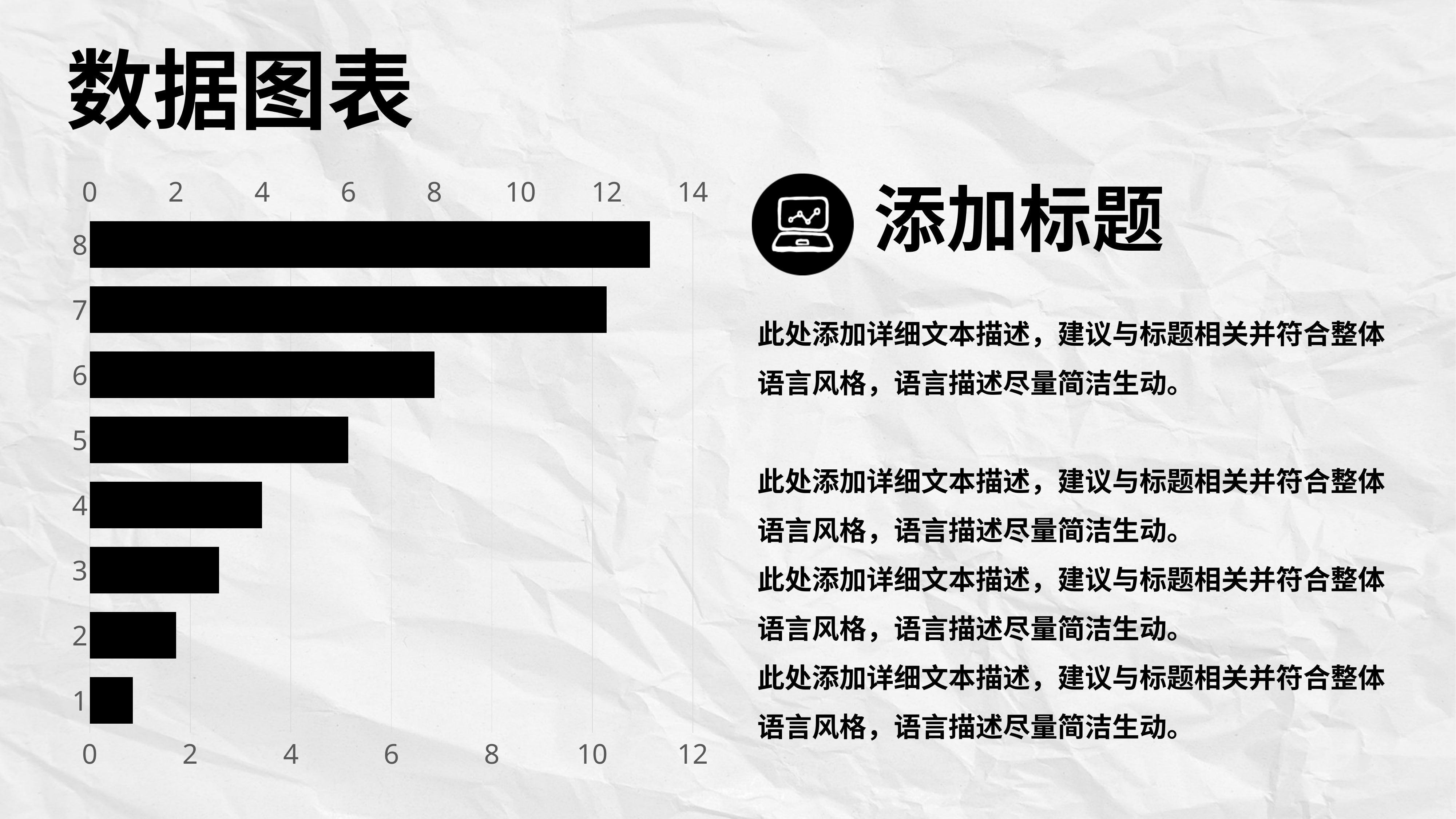
Is the value for category 1 greater or less than 2? less Is the value for category 7 greater or less than 8? greater Which has the larger value, category 8 or category 7? 8 Which category has the shortest bar? 1 Which has the larger value, category 5 or category 6? 6 What kind of chart is shown on the slide? bar chart Is the value for category 8 greater or less than 10? greater What is the title text at the top of the slide above the chart? 数据图表 How many categories (bars) does the chart show? 8 Which category has the longest bar? 8 Do the bar values increase or decrease going from category 1 up to category 8? increase